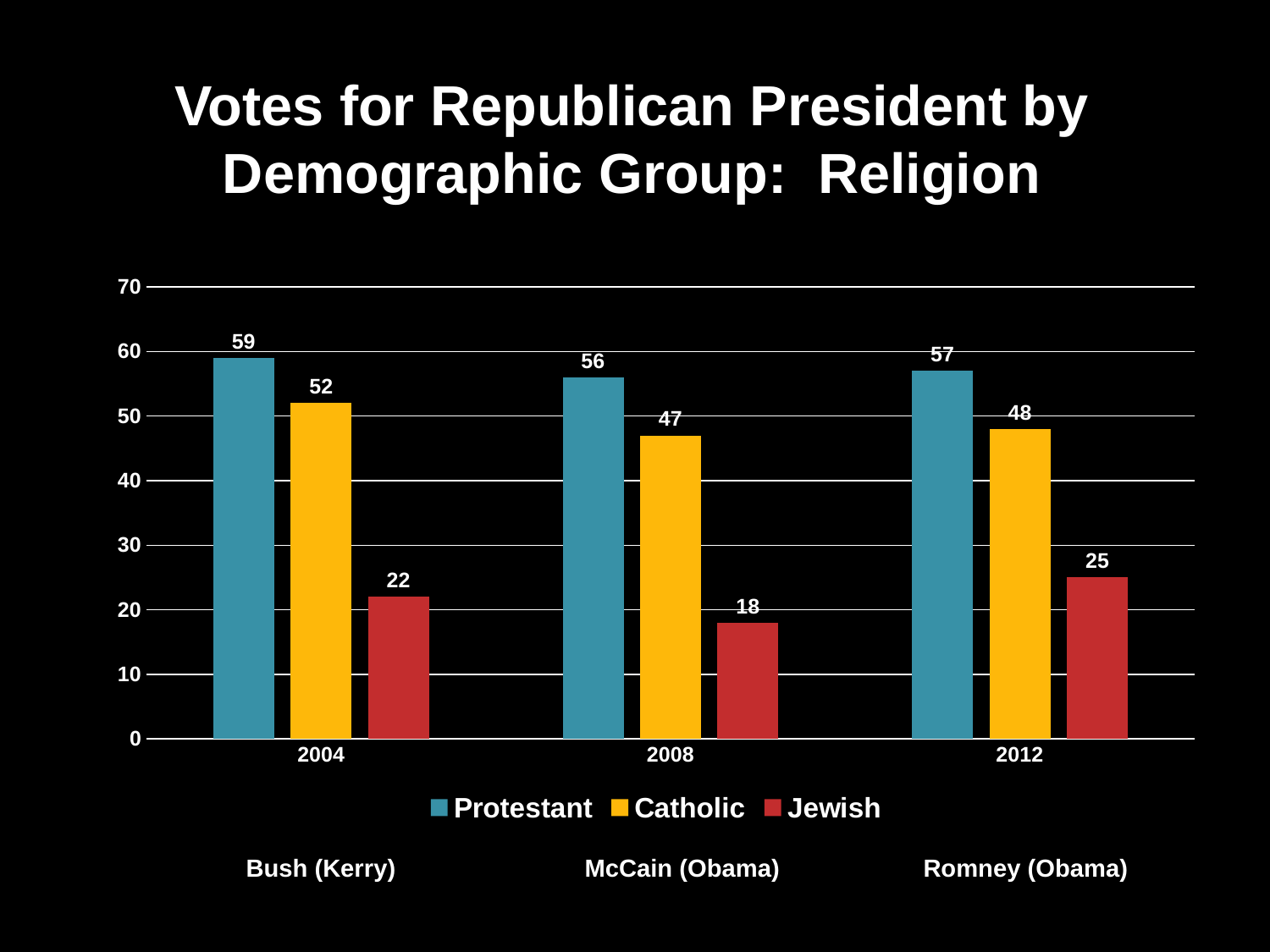
What kind of chart is shown on the slide? Bar chart How many series does the legend list? 3 What is the value for Protestant in 2004? 59 What is the value for Jewish in 2008? 18 What is the difference between the Protestant and Catholic values in 2008? 9 How many years are shown on the x axis? 3 Which is larger, the Jewish value in 2004 or the Jewish value in 2012? 2012 What colour are the Jewish bars? Red Which year has the highest Protestant value? 2004 Which year has the lowest Jewish value? 2008 Does the Catholic value rise or fall from 2004 to 2008? Fall What is the value for Catholic in 2012? 48